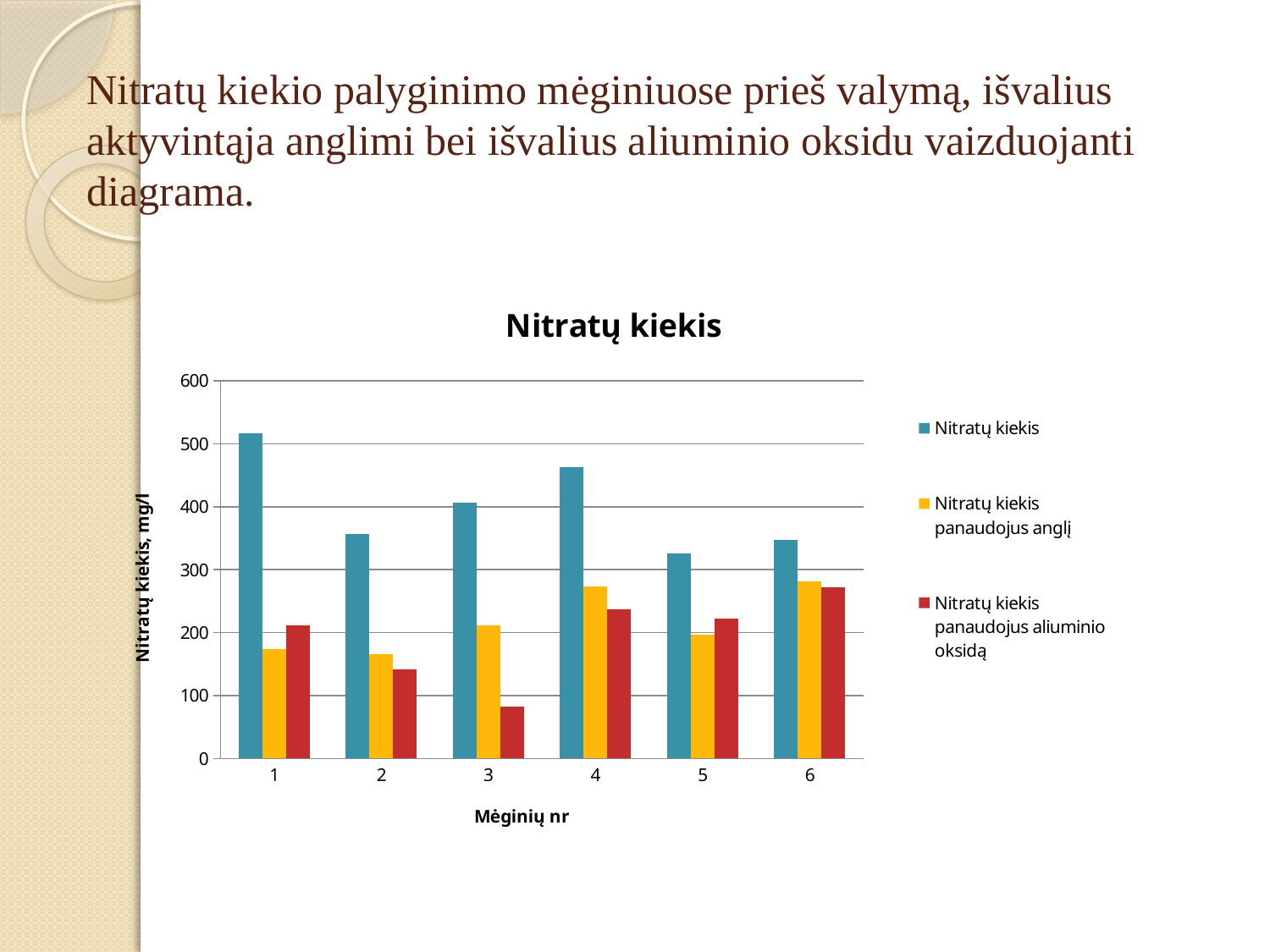
For sample 1, which is larger: 'Nitratų kiekis panaudojus anglį' or 'Nitratų kiekis panaudojus aliuminio oksidą'? Nitratų kiekis panaudojus aliuminio oksidą Is the value of 'Nitratų kiekis panaudojus aliuminio oksidą' for sample 3 greater or less than 100? less For sample 4, which is larger: 'Nitratų kiekis panaudojus anglį' or 'Nitratų kiekis panaudojus aliuminio oksidą'? Nitratų kiekis panaudojus anglį Is the value of 'Nitratų kiekis' for sample 2 greater or less than 400? less How many sample numbers (Mėginių nr) are shown on the x axis? 6 What is the label of the vertical axis of the chart? Nitratų kiekis, mg/l How many series does the legend list? 3 For the series 'Nitratų kiekis', which sample number has the highest value? 1 What kind of chart is shown on the slide? bar chart For the series 'Nitratų kiekis panaudojus aliuminio oksidą', which sample number has the lowest value? 3 Is the value of 'Nitratų kiekis' for sample 1 greater or less than 500? greater For the series 'Nitratų kiekis panaudojus aliuminio oksidą', which sample number has the highest value? 6